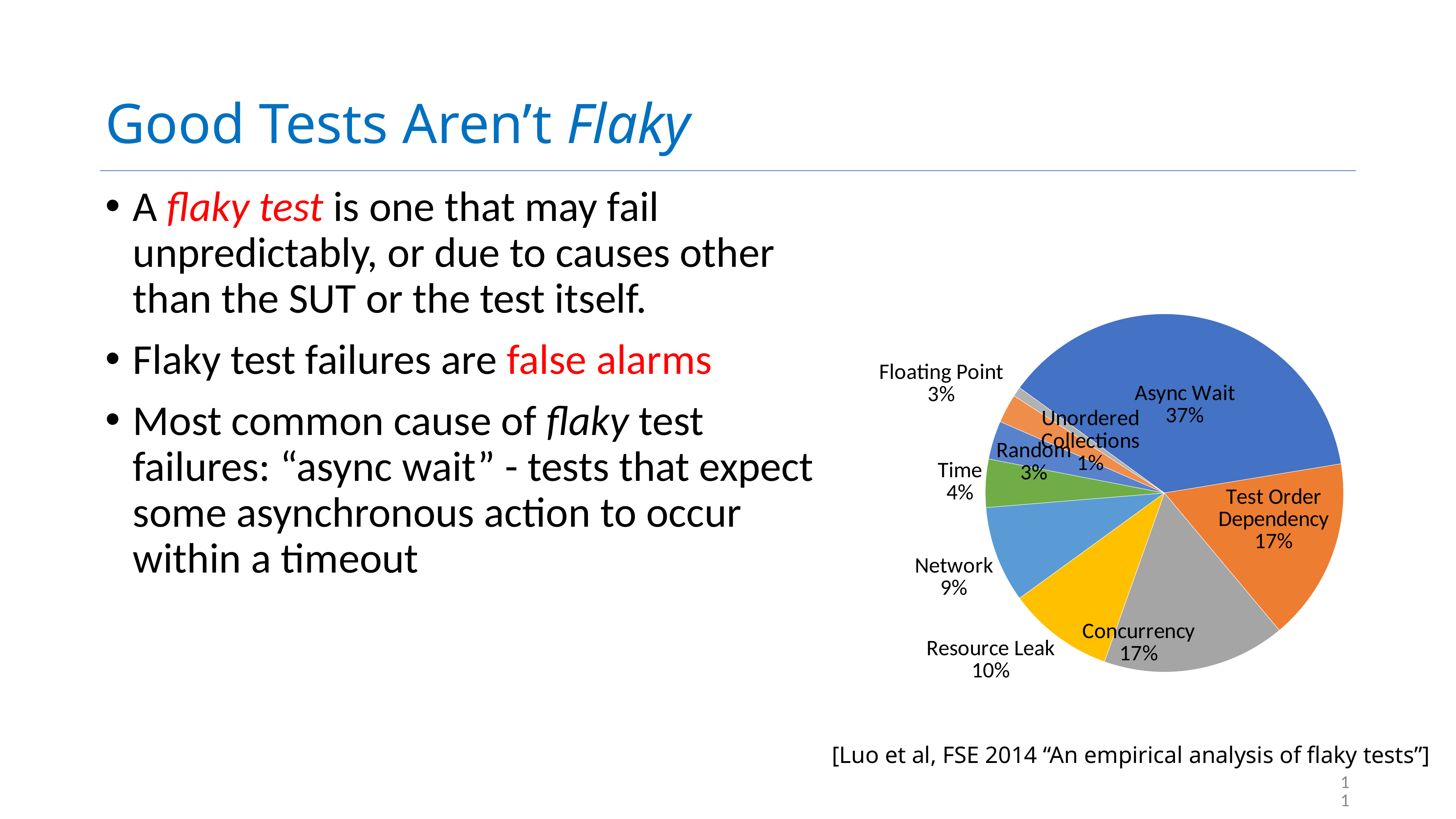
What is the value shown for Resource Leak? 10% Which category has the smallest slice of the pie? Unordered Collections What is the value shown for Test Order Dependency? 17% What is the value shown for Network? 9% Which is larger, the share for Network or the share for Time? Network What share of the pie does Async Wait account for? 37% Which category has the largest slice of the pie? Async Wait How many categories are shown in the pie chart? 9 What colour is the Async Wait slice? blue What is the difference between the Async Wait share and the Concurrency share? 20% What kind of chart is shown on the slide? pie chart What is the value shown for Unordered Collections? 1%